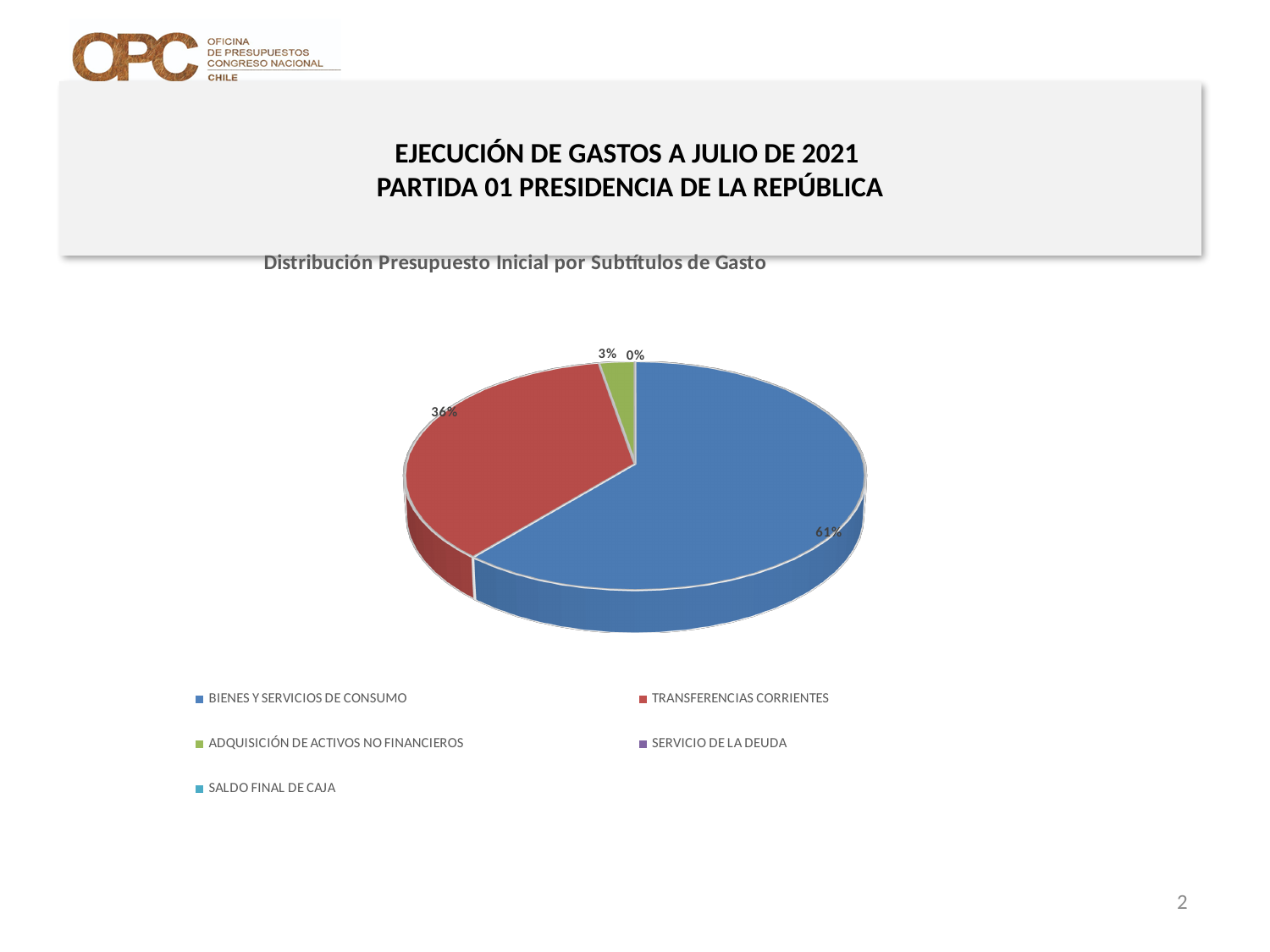
How many entries does the legend list? 5 Which is larger, the slice for TRANSFERENCIAS CORRIENTES or the slice for ADQUISICIÓN DE ACTIVOS NO FINANCIEROS? TRANSFERENCIAS CORRIENTES Which category has the largest slice of the pie? BIENES Y SERVICIOS DE CONSUMO What is the title of the chart? Distribución Presupuesto Inicial por Subtítulos de Gasto What share of the pie does TRANSFERENCIAS CORRIENTES represent? 36% What is the difference in percentage points between BIENES Y SERVICIOS DE CONSUMO and TRANSFERENCIAS CORRIENTES? 25 percentage points Which category has the second-largest slice of the pie? TRANSFERENCIAS CORRIENTES Is the share for TRANSFERENCIAS CORRIENTES greater or less than 50%? less What colour is the slice for BIENES Y SERVICIOS DE CONSUMO? blue What share of the pie does BIENES Y SERVICIOS DE CONSUMO represent? 61% What share of the pie does ADQUISICIÓN DE ACTIVOS NO FINANCIEROS represent? 3% What kind of chart is shown on the slide? pie chart